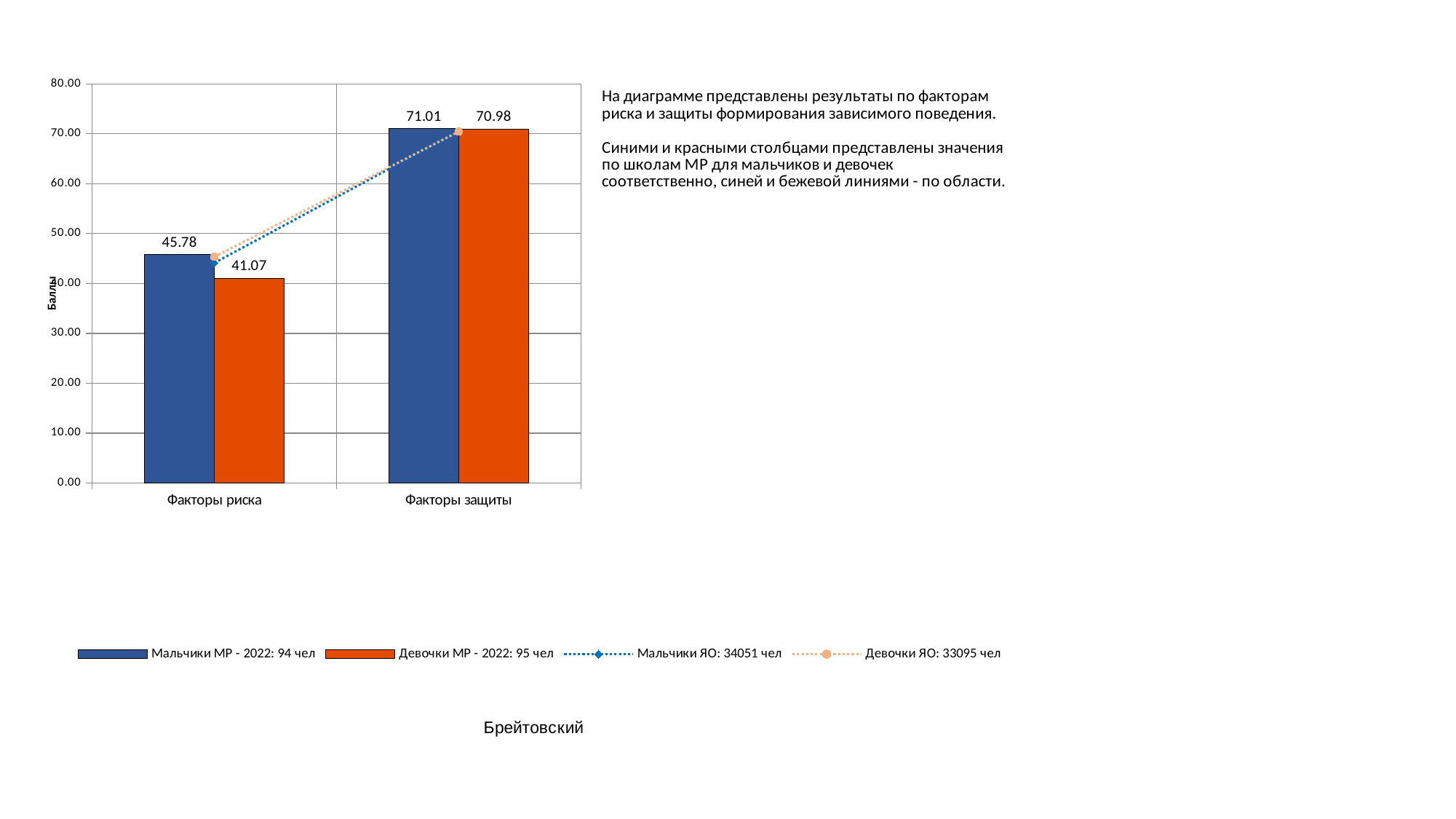
What is the value of the Девочки МР - 2022 bar for Факторы защиты? 70.98 What is the difference between the Мальчики МР - 2022 and Девочки МР - 2022 values for Факторы риска? 4.71 What is the value of the Мальчики МР - 2022 bar for Факторы защиты? 71.01 Which category has the highest Мальчики МР - 2022 value? Факторы защиты How many series does the legend list? 4 What kind of chart is shown on the slide? Combination bar and line chart What is the value of the Мальчики МР - 2022 bar for Факторы риска? 45.78 How many categories are shown on the x axis? 2 Is the Мальчики ЯО line value for Факторы риска greater or less than 50? less What is the value of the Девочки МР - 2022 bar for Факторы риска? 41.07 For Факторы риска, which bar is higher: Мальчики МР - 2022 or Девочки МР - 2022? Мальчики МР - 2022 What is the label of the vertical axis? Баллы